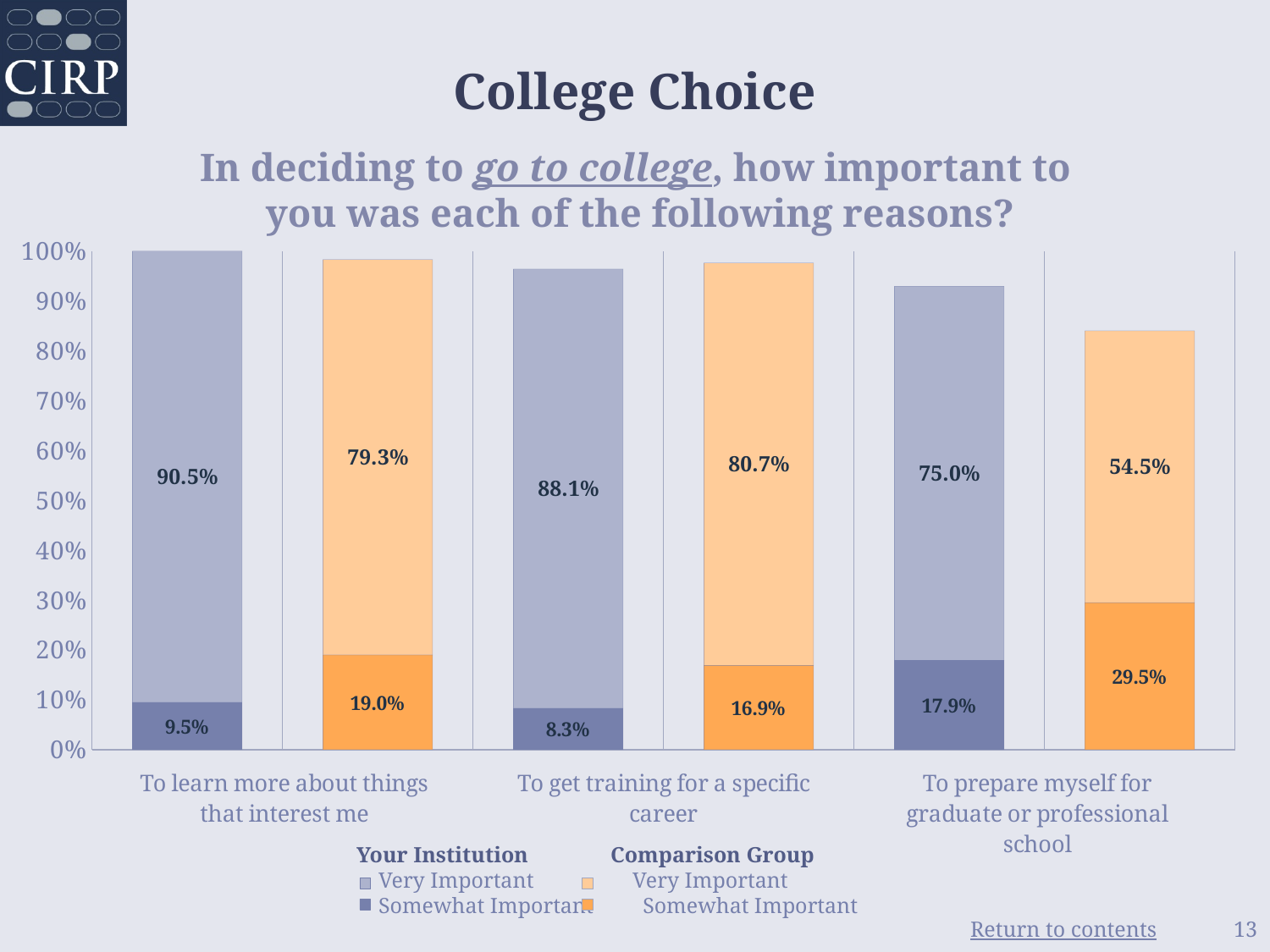
For "To get training for a specific career", which group has the larger Somewhat Important percentage, Your Institution or the Comparison Group? Comparison Group What type of chart is shown on the slide? Stacked bar chart Which reason has the highest Very Important percentage for Your Institution? To learn more about things that interest me How many series does the chart legend list? 4 What percentage of Your Institution students rated "To get training for a specific career" as Somewhat Important? 8.3% What is the combined Very Important and Somewhat Important percentage for the Comparison Group for "To learn more about things that interest me"? 98.3% What percentage of the Comparison Group rated "To prepare myself for graduate or professional school" as Somewhat Important? 29.5% Which reason has the lowest Very Important percentage for the Comparison Group? To prepare myself for graduate or professional school What is the combined Very Important and Somewhat Important percentage for Your Institution for "To prepare myself for graduate or professional school"? 92.9% What is the difference between the Very Important percentages for Your Institution and the Comparison Group for "To prepare myself for graduate or professional school"? 20.5% How many reasons (categories) are shown on the x axis of the chart? 3 What percentage of Your Institution students rated "To learn more about things that interest me" as Very Important? 90.5%